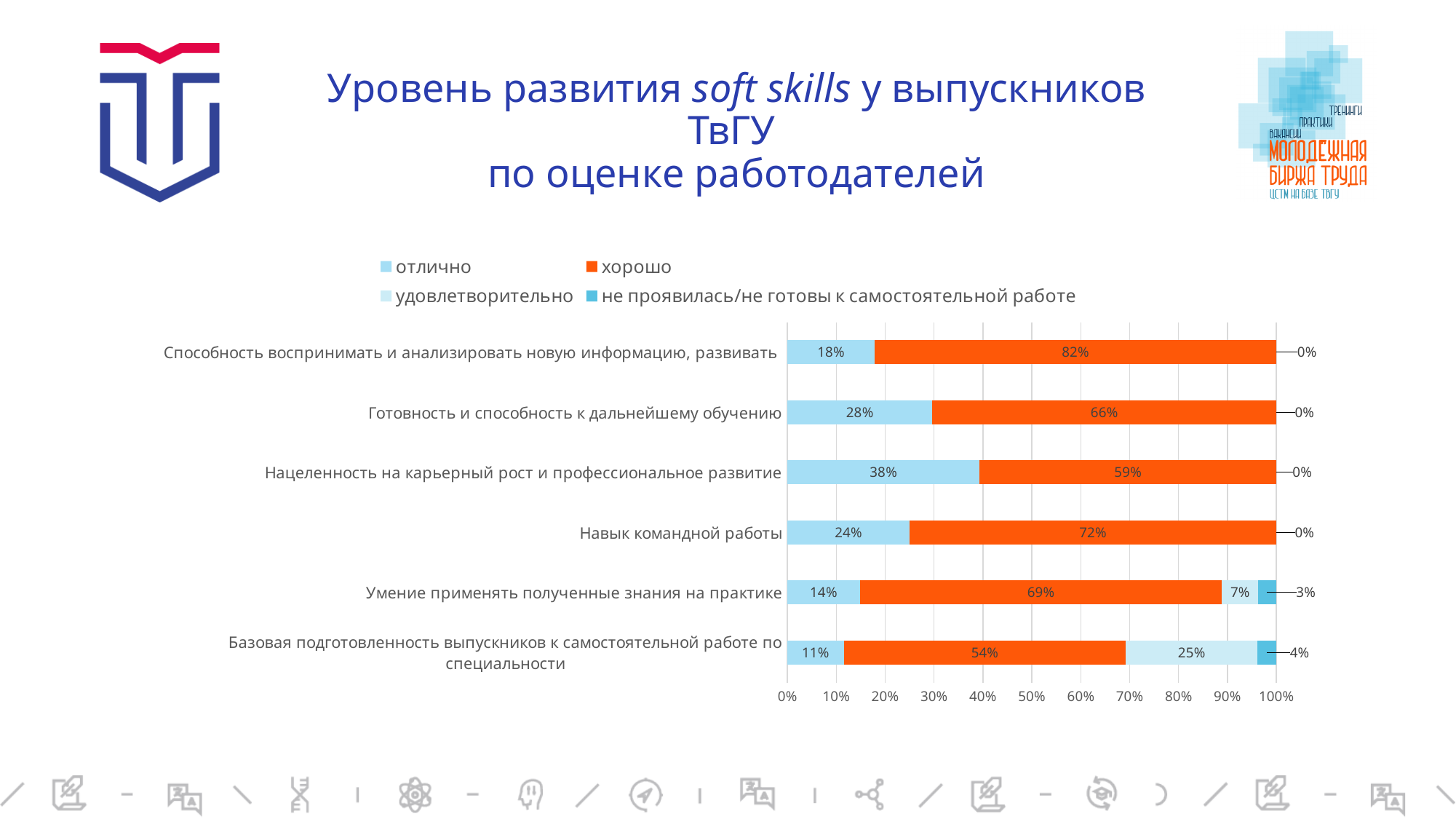
How many categories (skills) are plotted on the chart? 6 What kind of chart is shown on the slide? Stacked bar chart What is the "удовлетворительно" value for "Базовая подготовленность выпускников к самостоятельной работе по специальности"? 25% Which category has the highest "отлично" value? Нацеленность на карьерный рост и профессиональное развитие What colour represents the "хорошо" series in the legend? Orange What is the "не проявилась/не готовы к самостоятельной работе" value for "Умение применять полученные знания на практике"? 3% What is the difference between the "хорошо" values for "Навык командной работы" and "Базовая подготовленность выпускников к самостоятельной работе по специальности"? 18% Which has the larger "отлично" value: "Готовность и способность к дальнейшему обучению" or "Умение применять полученные знания на практике"? Готовность и способность к дальнейшему обучению What is the "хорошо" value for "Способность воспринимать и анализировать новую информацию, развивать"? 82% What is the "отлично" value for "Навык командной работы"? 24% How many series does the legend list? 4 Which category has the lowest "отлично" value? Базовая подготовленность выпускников к самостоятельной работе по специальности